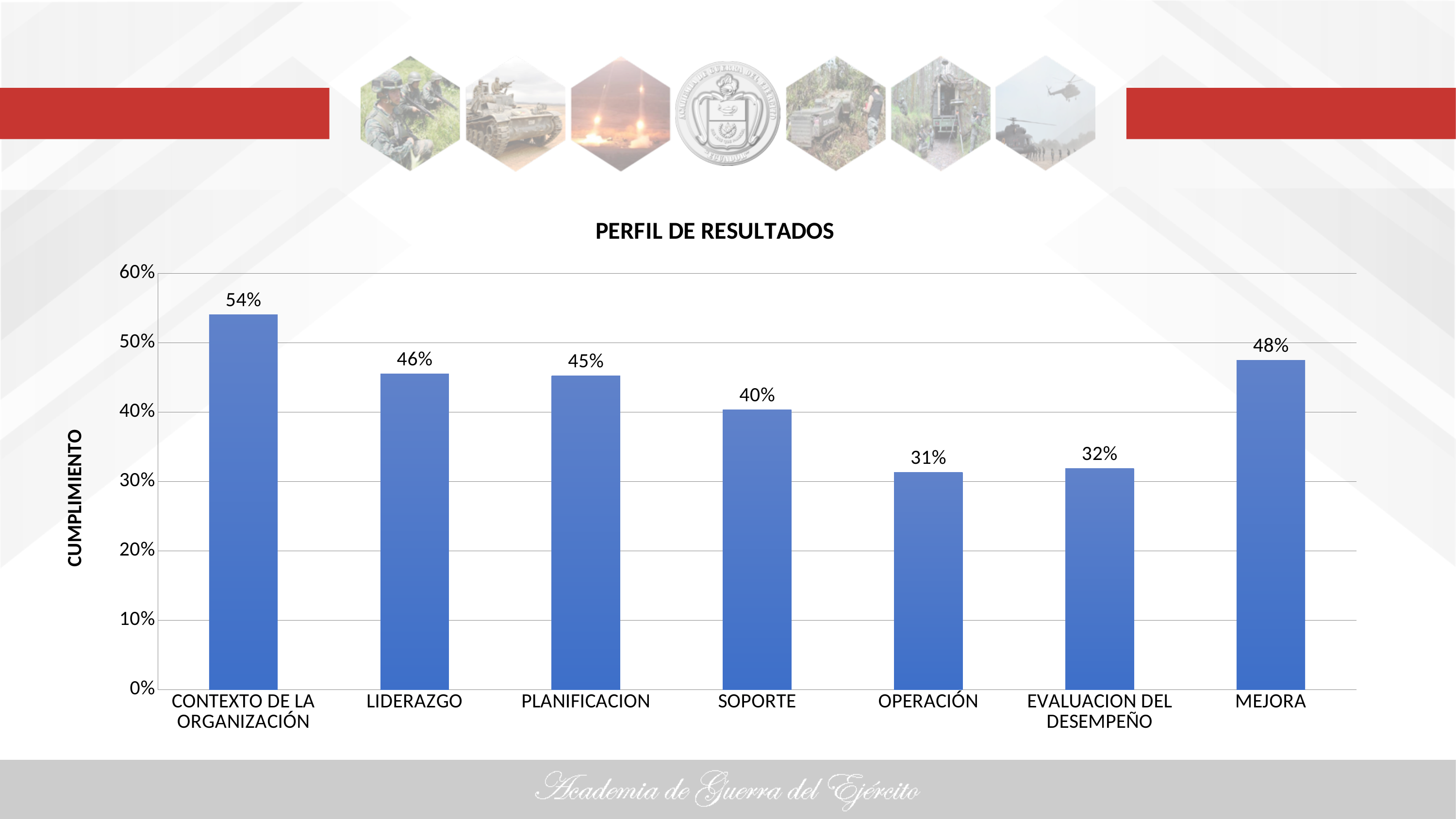
How many categories are shown on the x axis? 7 Which is larger, the value for LIDERAZGO or the value for EVALUACION DEL DESEMPEÑO? LIDERAZGO What kind of chart is shown on the slide? bar chart Which category has the lowest value? OPERACIÓN Which category has the highest value? CONTEXTO DE LA ORGANIZACIÓN What is the difference between the values for CONTEXTO DE LA ORGANIZACIÓN and OPERACIÓN? 23% Is the value for PLANIFICACION greater or less than 40%? greater What is the value for MEJORA? 48% What is the difference between the values for MEJORA and SOPORTE? 8% What is the value for CONTEXTO DE LA ORGANIZACIÓN? 54% What is the title of the chart? PERFIL DE RESULTADOS What is the value for SOPORTE? 40%